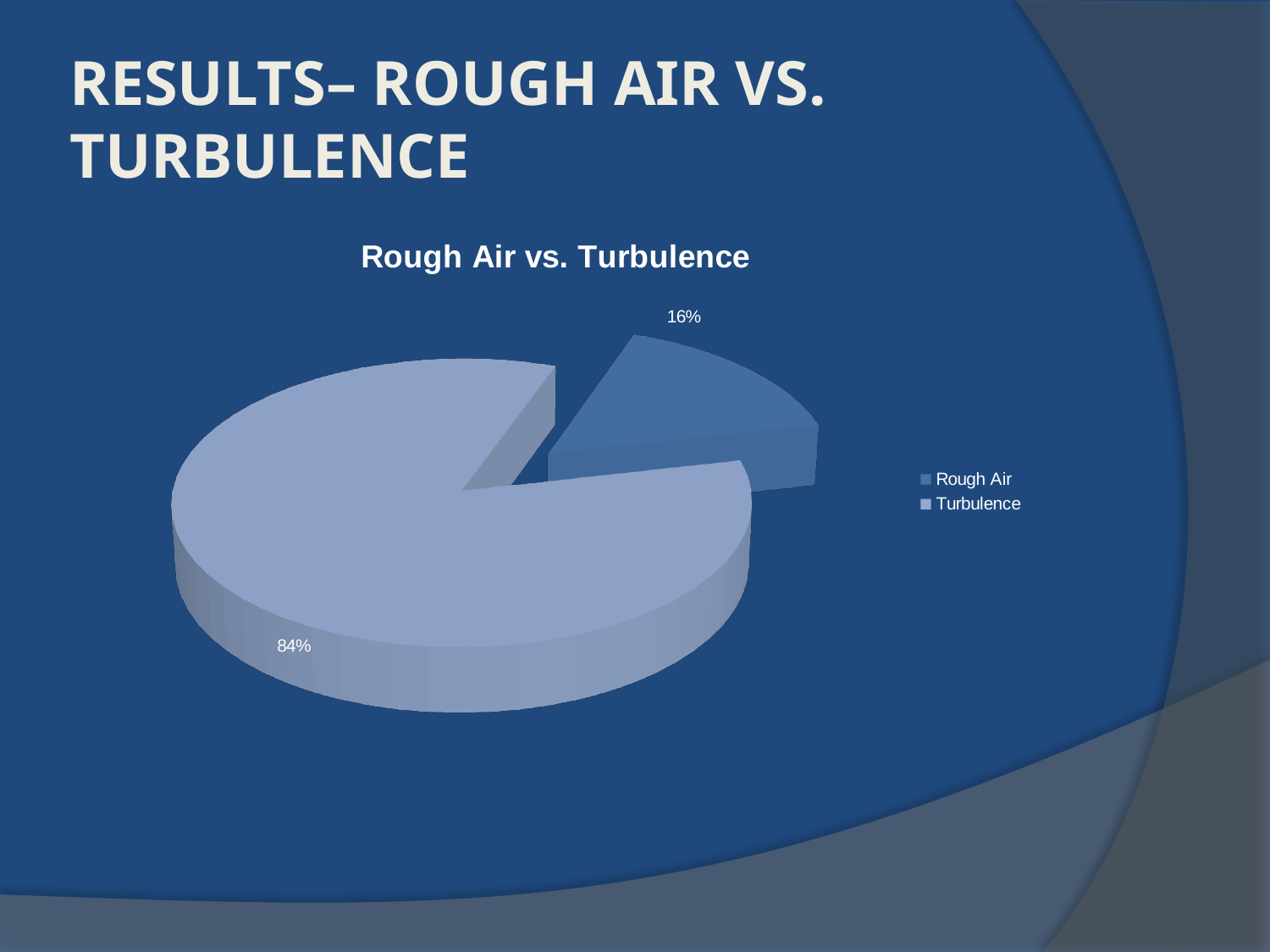
Which legend entry is listed first? Rough Air How many slices does the pie chart have? 2 How many entries does the legend list? 2 Which is larger, the Rough Air slice or the Turbulence slice? Turbulence Which category has the smallest slice of the pie? Rough Air Which category has the largest slice of the pie? Turbulence What kind of chart is shown on the slide? Pie chart What share of the pie does Rough Air account for? 16% What is the title of the chart? Rough Air vs. Turbulence What is the difference in percentage points between the Rough Air and Turbulence slices? 68 What share of the pie does Turbulence account for? 84%